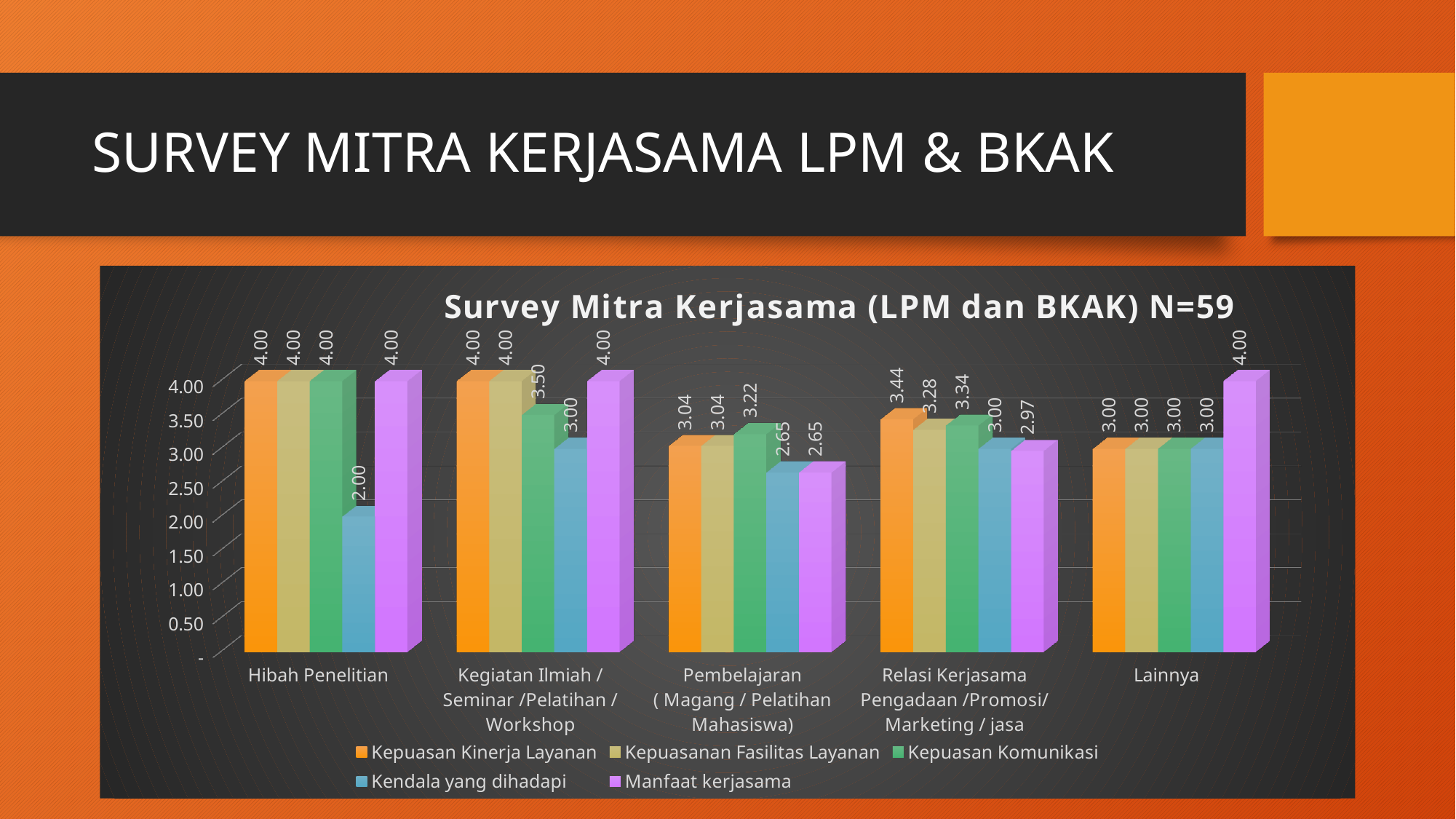
What is the difference between Kepuasan Komunikasi and Kendala yang dihadapi for Pembelajaran ( Magang / Pelatihan Mahasiswa)? 0.57 What is the value of Kepuasan Kinerja Layanan for Relasi Kerjasama Pengadaan /Promosi/ Marketing / jasa? 3.44 What is the value of Kepuasan Komunikasi for Kegiatan Ilmiah / Seminar /Pelatihan / Workshop? 3.50 What is the sample size stated in the chart title? N=59 For Relasi Kerjasama Pengadaan /Promosi/ Marketing / jasa, which is larger: Kepuasan Kinerja Layanan or Kepuasanan Fasilitas Layanan? Kepuasan Kinerja Layanan How many series does the legend list? 5 What type of chart is shown on the slide? Bar chart How many categories are shown on the x axis? 5 Which series has the lowest value for Hibah Penelitian? Kendala yang dihadapi What is the value of Manfaat kerjasama for Pembelajaran ( Magang / Pelatihan Mahasiswa)? 2.65 What is the value of Kendala yang dihadapi for Hibah Penelitian? 2.00 Which series has the highest value for Lainnya? Manfaat kerjasama